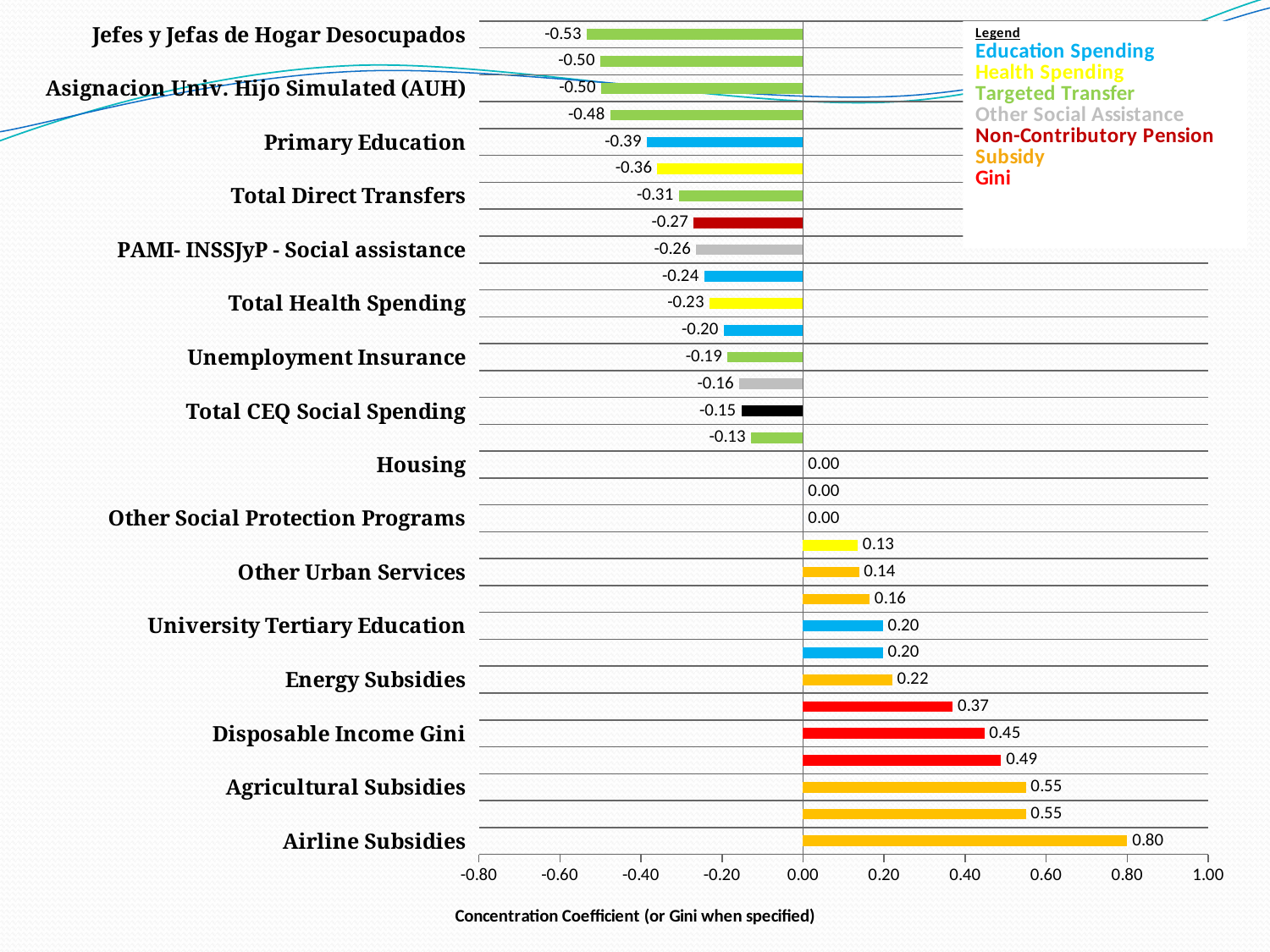
What is the value shown for Disposable Income Gini? 0.45 What is the concentration coefficient for Airline Subsidies? 0.80 How many entries does the legend list? 7 What is the difference between the values for Airline Subsidies and Agricultural Subsidies? 0.25 What kind of chart is shown on the slide? bar chart What is the title of the horizontal axis? Concentration Coefficient (or Gini when specified) Which is larger, the value for Energy Subsidies or the value for University Tertiary Education? Energy Subsidies Which labeled category has the lowest value? Jefes y Jefas de Hogar Desocupados What is the value shown for Jefes y Jefas de Hogar Desocupados? -0.53 Is the value for Disposable Income Gini greater or less than 0.40? greater Which labeled category has the highest value? Airline Subsidies What is the value shown for Primary Education? -0.39